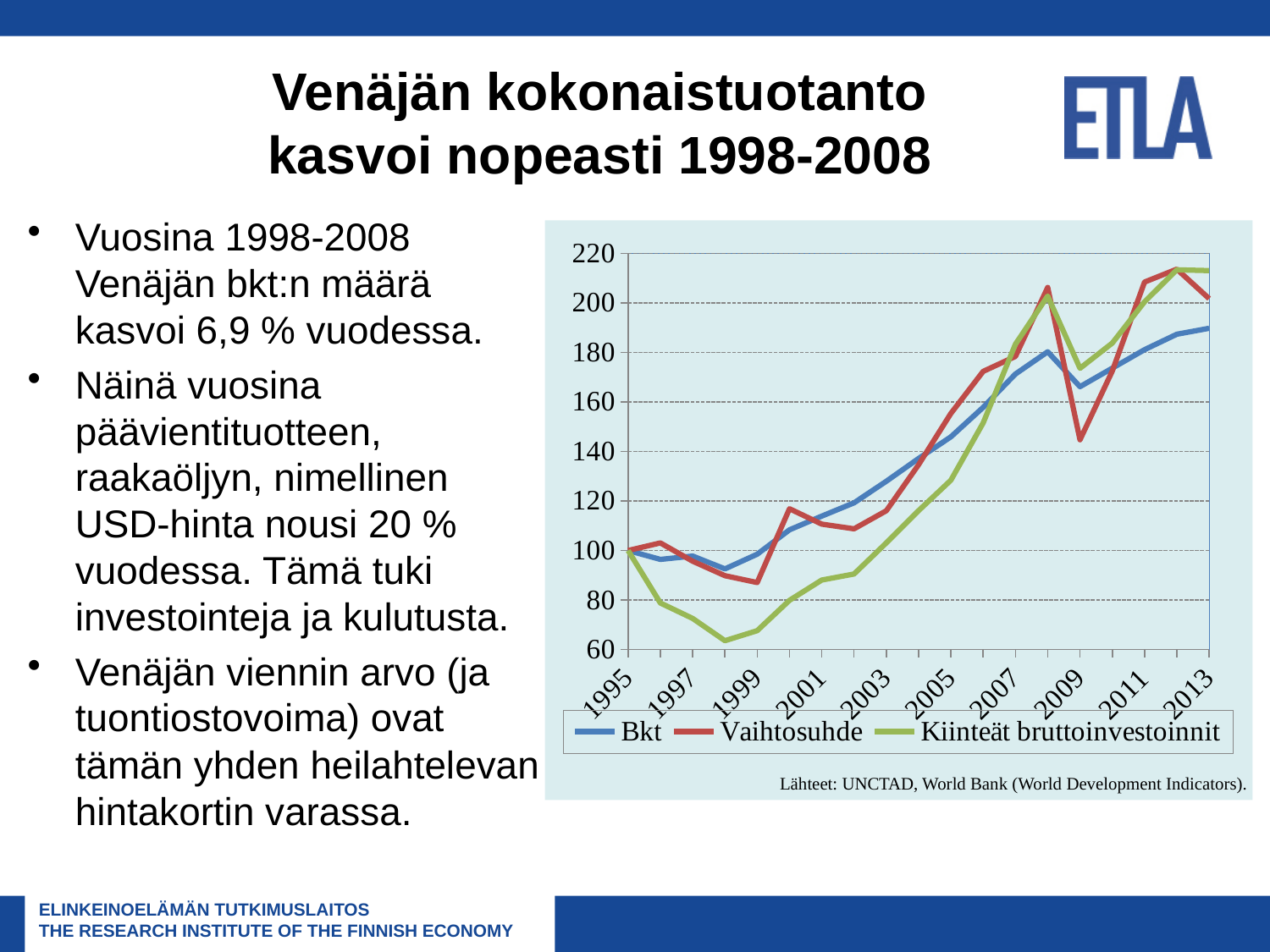
What kind of chart is shown on the slide? line chart Does the Kiinteät bruttoinvestoinnit series rise or fall between 1995 and 1999? fall Is the value of Kiinteät bruttoinvestoinnit in 2013 greater or less than 200? greater In 2001, which is larger: Vaihtosuhde or Kiinteät bruttoinvestoinnit? Vaihtosuhde Is the value of Vaihtosuhde in 2009 greater or less than 160? less What are the three series named in the chart's legend? Bkt, Vaihtosuhde, Kiinteät bruttoinvestoinnit What colour is the Bkt line in the chart? blue Is the value of Kiinteät bruttoinvestoinnit in 1999 greater or less than 80? less How many series does the chart's legend list? 3 In 2009, which is larger: Bkt or Vaihtosuhde? Bkt What is the value of the Bkt series in 1995? 100